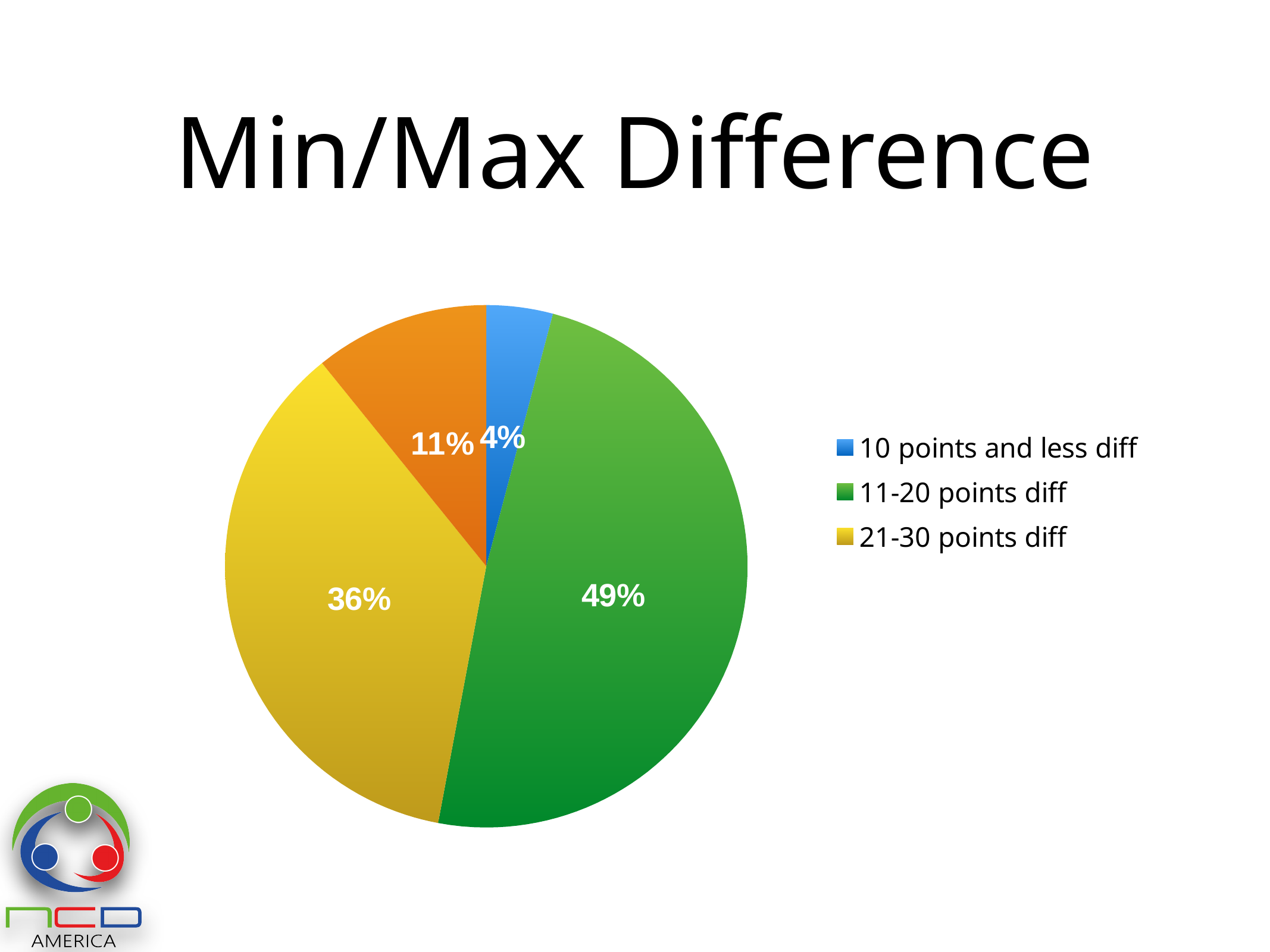
Which slice has the smallest share of the pie? 10 points and less diff Which is larger: the '21-30 points diff' slice or the '10 points and less diff' slice? 21-30 points diff Which legend category has the largest share of the pie? 11-20 points diff What percentage is shown on the orange slice of the pie? 11% What is the title of the chart? Min/Max Difference How many entries does the legend list? 3 What kind of chart is shown on the slide? pie chart How many slices does the pie chart have? 4 What percentage of the pie is the '10 points and less diff' slice? 4% What percentage of the pie is the '21-30 points diff' slice? 36% What percentage of the pie is the '11-20 points diff' slice? 49% By how many percentage points does the '11-20 points diff' slice exceed the '21-30 points diff' slice? 13 percentage points